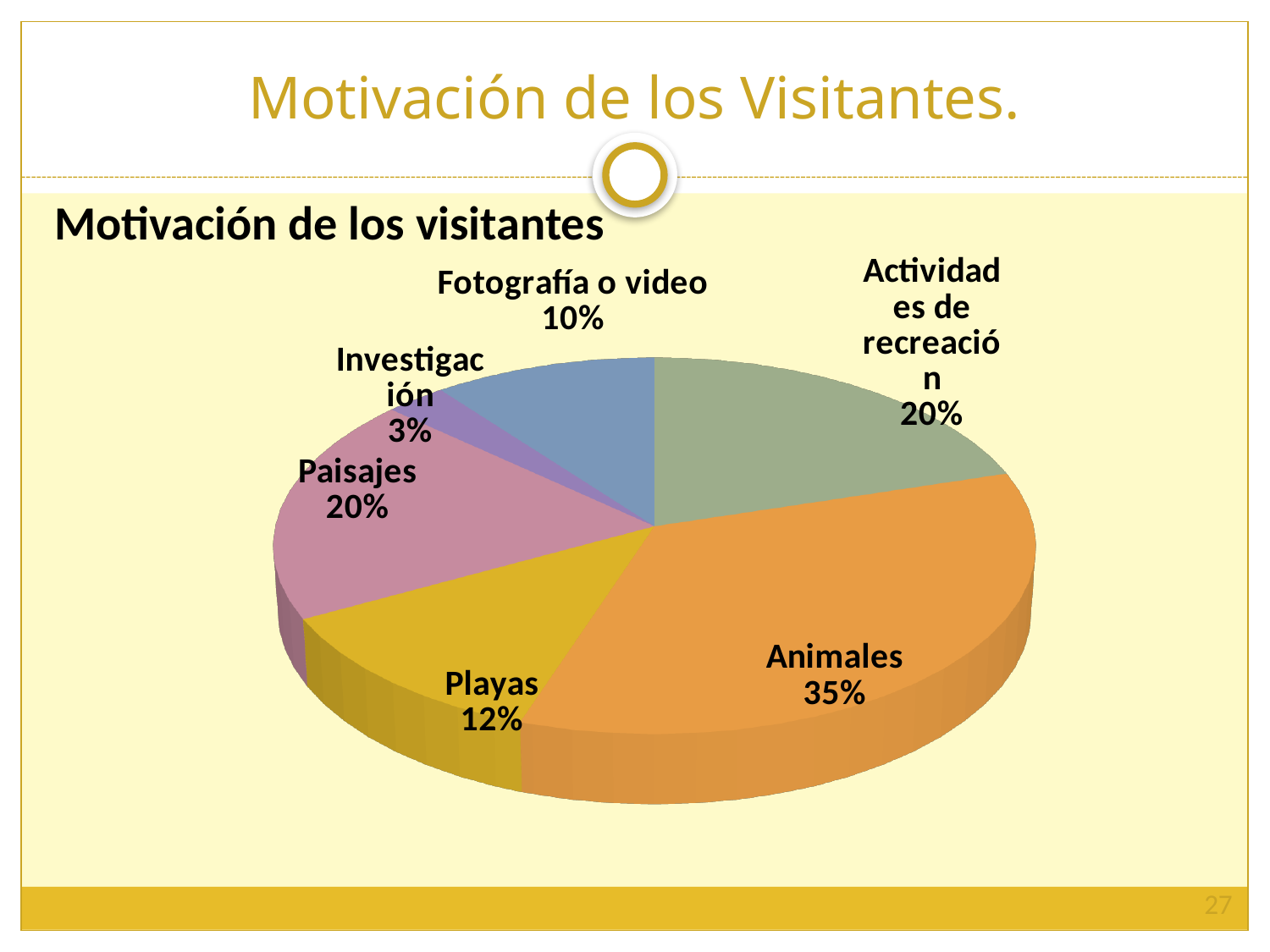
Which category has the largest slice of the pie? Animales How many categories are shown in the pie chart? 6 What share of the pie does Animales represent? 35% What is the title of the chart? Motivación de los visitantes What is the value shown for Fotografía o video? 10% Which is larger, Paisajes or Fotografía o video? Paisajes What is the difference between the Animales and Playas percentages? 23% What is the combined percentage of Paisajes and Actividades de recreación? 40% Which category has the smallest slice of the pie? Investigación What is the value shown for Playas? 12% What kind of chart is shown on the slide? Pie chart What is the value shown for Investigación? 3%